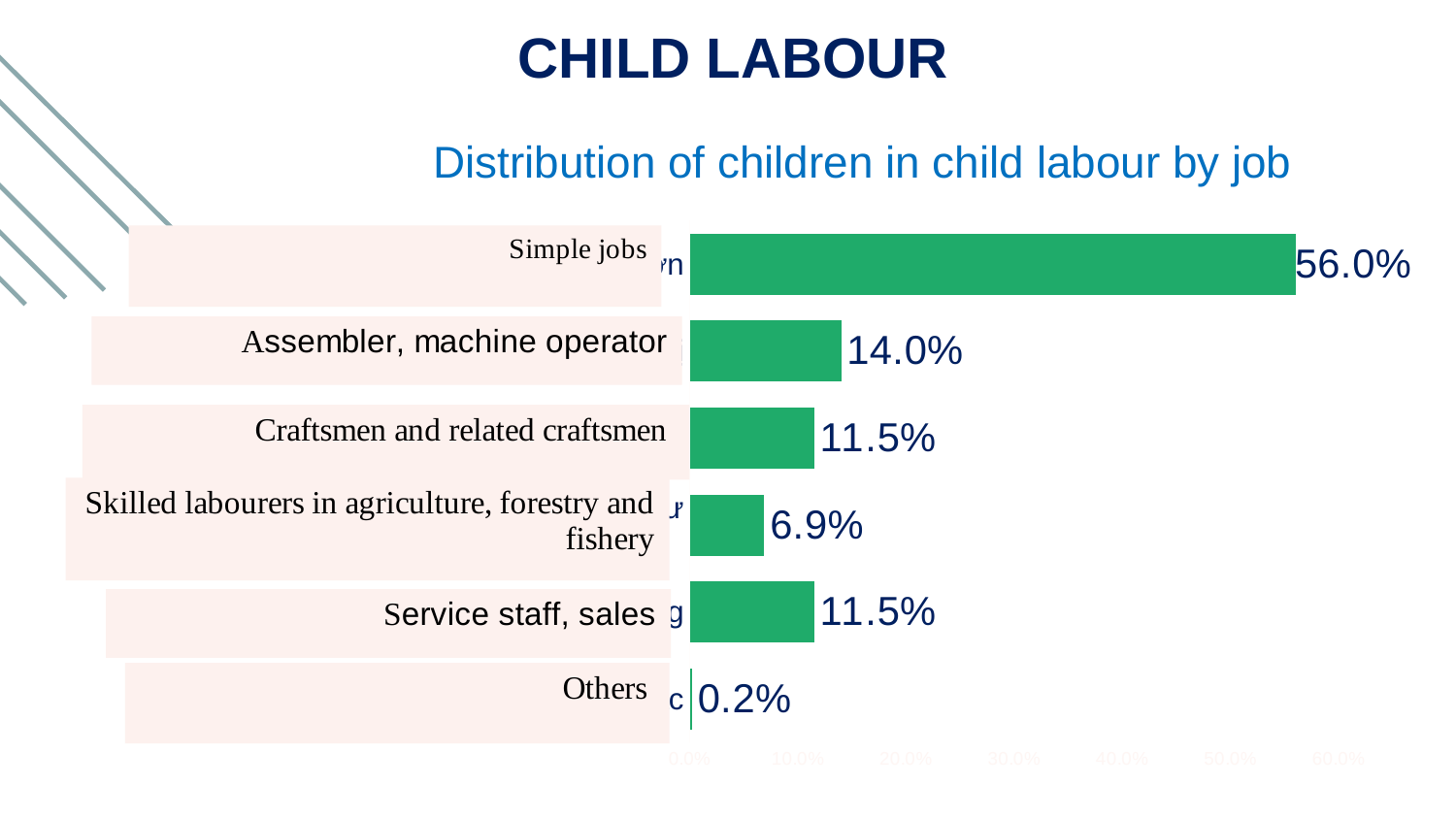
Which job category has the lowest share of children in child labour? Others What type of chart is shown on the slide? Bar chart How many job categories are shown in the chart? 6 Which job category has the highest share of children in child labour? Simple jobs What is the title of the chart? Distribution of children in child labour by job Which is larger, the value for Assembler, machine operator or the value for Service staff, sales? Assembler, machine operator What is the value for Skilled labourers in agriculture, forestry and fishery? 6.9% What percentage of children in child labour work in simple jobs? 56.0% What is the value for Others? 0.2% What is the difference between the values for Simple jobs and Assembler, machine operator? 42.0% What is the value for Assembler, machine operator? 14.0% What is the difference between the values for Craftsmen and related craftsmen and Skilled labourers in agriculture, forestry and fishery? 4.6%